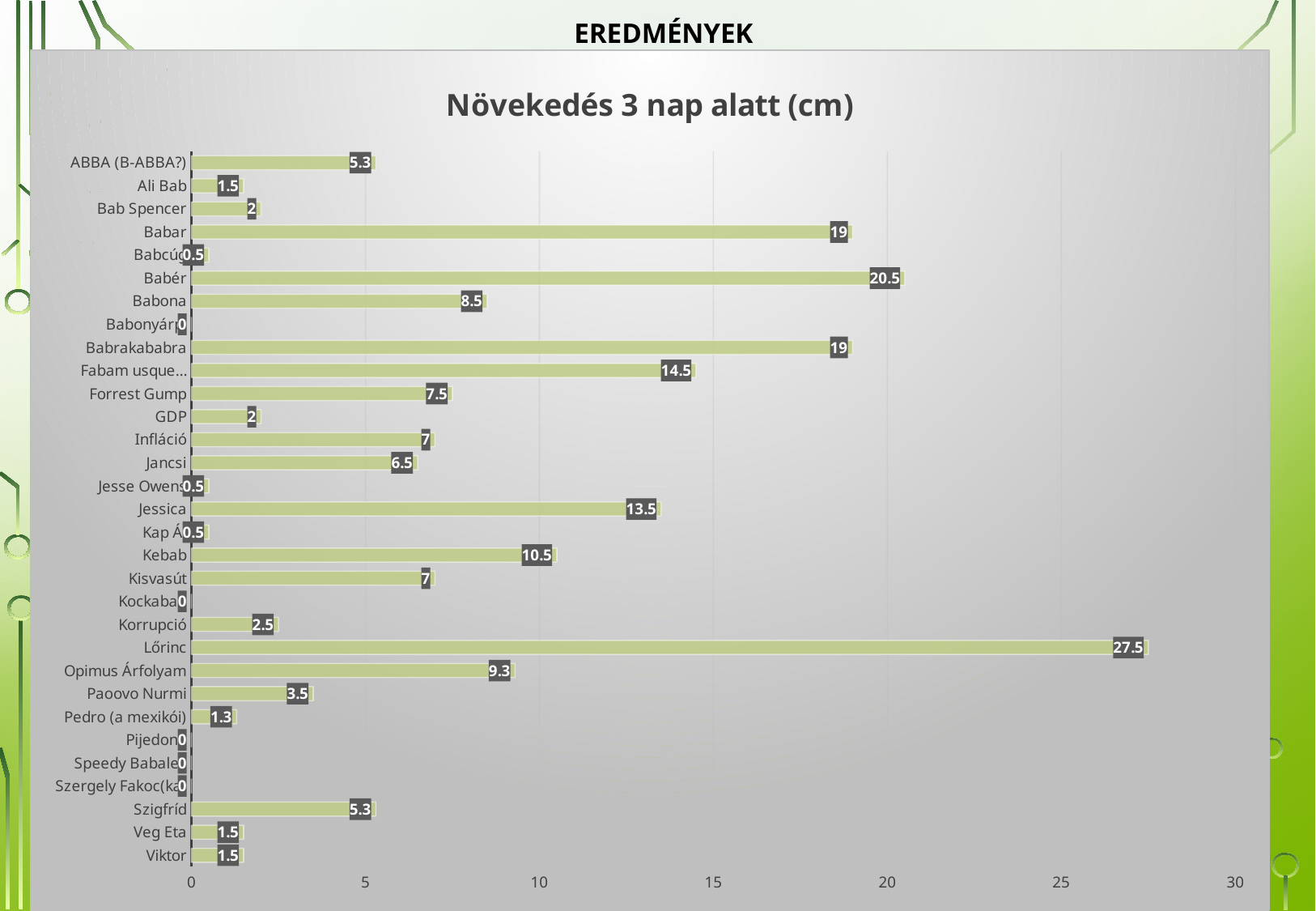
What is the value for Opimus Árfolyam? 9.3 What is the difference between the values for Fabam usque... and Forrest Gump? 7 How many categories have a value of 0? 5 What is the difference between the values for Babér and Babar? 1.5 Which is larger, the value for Kebab or the value for Babona? Kebab What is the value for Lőrinc? 27.5 What type of chart is shown on the slide? bar chart Which category has the highest value? Lőrinc What is the value for Jessica? 13.5 What is the chart's title? Növekedés 3 nap alatt (cm) How many categories are shown on the chart? 31 What is the value for Babér? 20.5